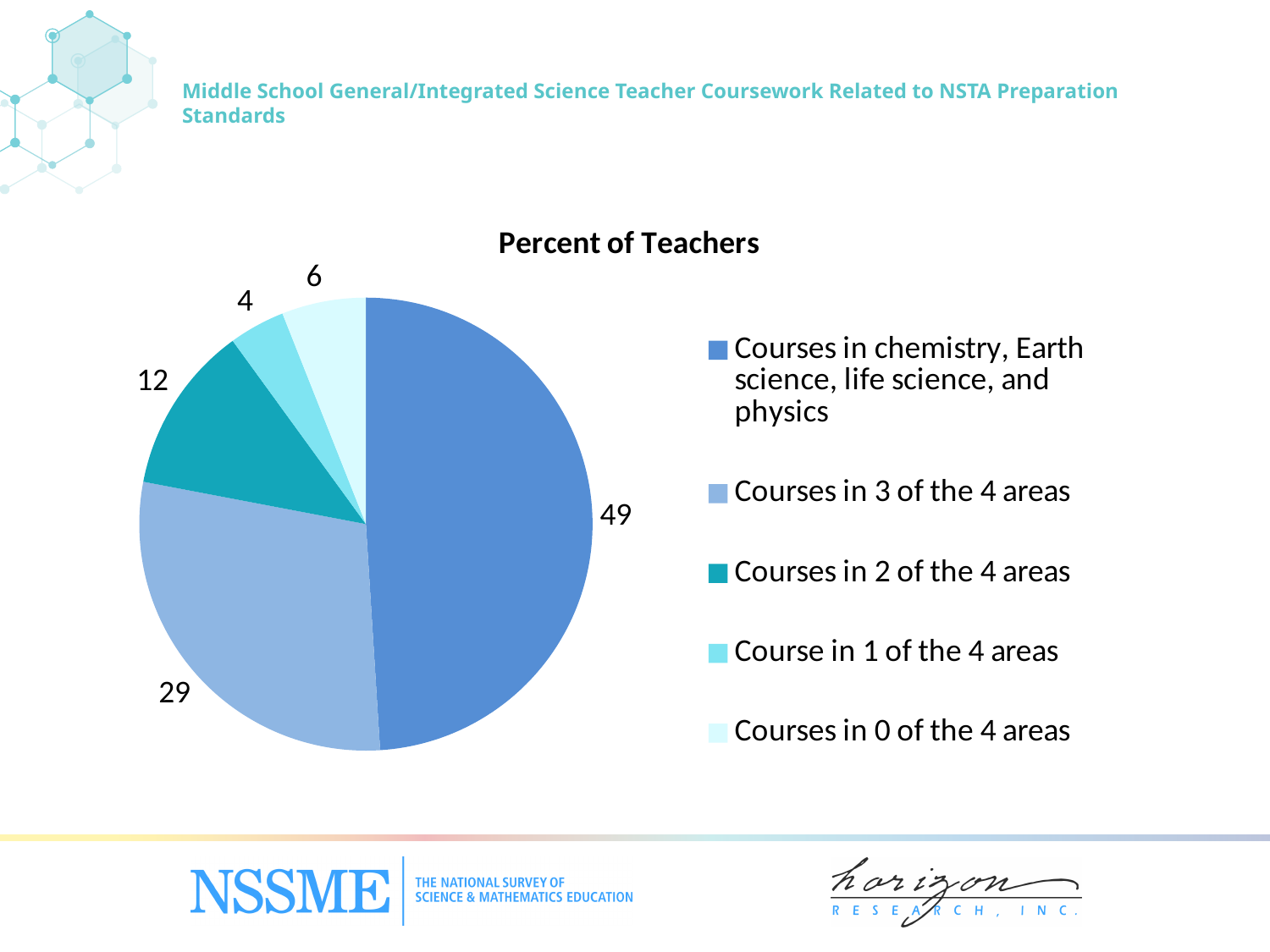
What is the difference between the percent of teachers with courses in all 4 areas and those with courses in 3 of the 4 areas? 20 Which is larger: the slice for courses in 0 of the 4 areas or the slice for a course in 1 of the 4 areas? Courses in 0 of the 4 areas What kind of chart is shown on the slide? Pie chart How many categories does the legend list? 5 What percent of teachers had a course in 1 of the 4 areas? 4 Which category has the smallest slice of the pie? Course in 1 of the 4 areas Which category has the largest slice of the pie? Courses in chemistry, Earth science, life science, and physics What is the chart's title? Percent of Teachers What percent of teachers had courses in 0 of the 4 areas? 6 What percent of teachers had courses in chemistry, Earth science, life science, and physics? 49 What percent of teachers had courses in 2 of the 4 areas? 12 What percent of teachers had courses in 3 of the 4 areas? 29